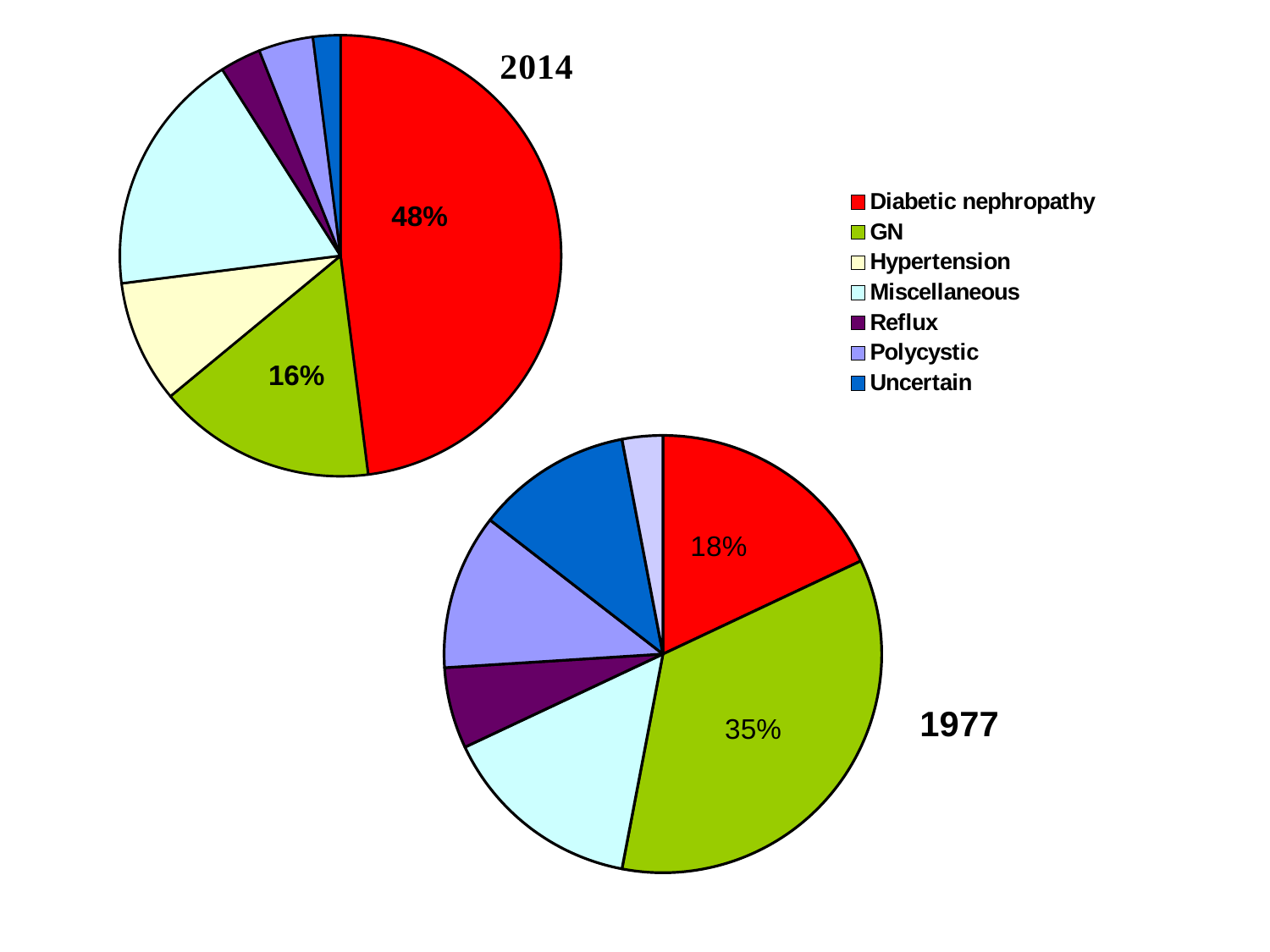
In the 2014 pie chart, what share is labelled for Diabetic nephropathy? 48% In the 2014 pie chart, what share is labelled for GN? 16% In the 1977 pie chart, what share is labelled for Diabetic nephropathy? 18% In the 2014 pie chart, which category has the largest slice? Diabetic nephropathy What type of charts are shown on the slide? Pie charts How many categories does the legend list? 7 In the 2014 pie chart, how many percentage points larger is Diabetic nephropathy than GN? 32 percentage points In the 1977 pie chart, how many percentage points larger is GN than Diabetic nephropathy? 17 percentage points In the 1977 pie chart, what share is labelled for GN? 35% In the 1977 pie chart, which category has the largest slice? GN Is the Diabetic nephropathy share larger in the 2014 pie chart or the 1977 pie chart? 2014 In the 2014 pie chart, which slice is larger, Miscellaneous or Hypertension? Miscellaneous